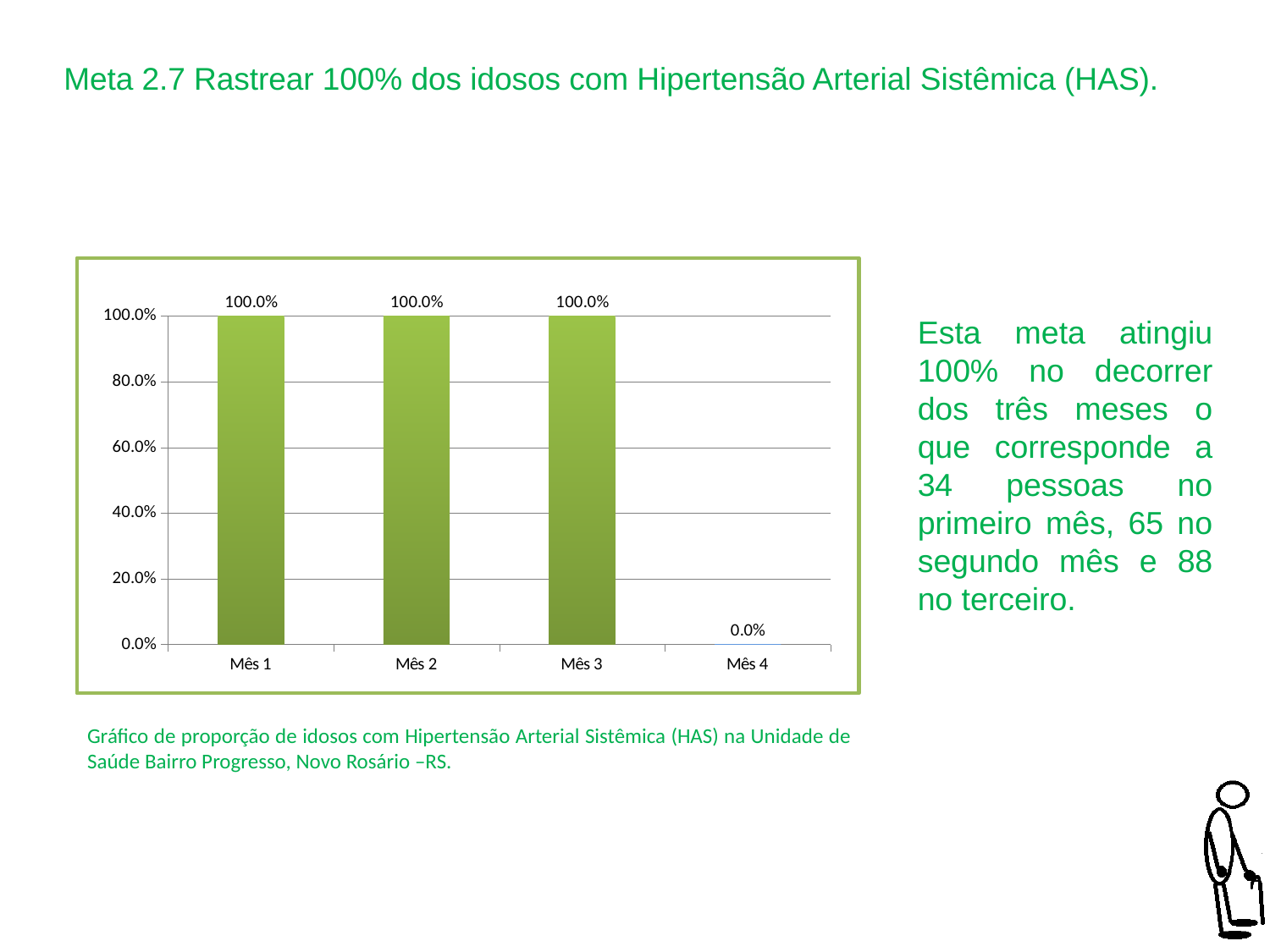
What is the difference between the values for Mês 2 and Mês 4? 100.0% What is the highest value shown on the y axis? 100.0% How many categories are shown on the x axis? 4 What is the value for Mês 4? 0.0% Which is larger, the value for Mês 3 or the value for Mês 4? Mês 3 What is the value for Mês 3? 100.0% Which category has the lowest value? Mês 4 What is the value for Mês 1? 100.0% What kind of chart is shown on the slide? bar chart Do the values rise or fall from Mês 3 to Mês 4? fall Is the value for Mês 2 greater or less than 80.0%? greater What colour are the bars in the chart? green